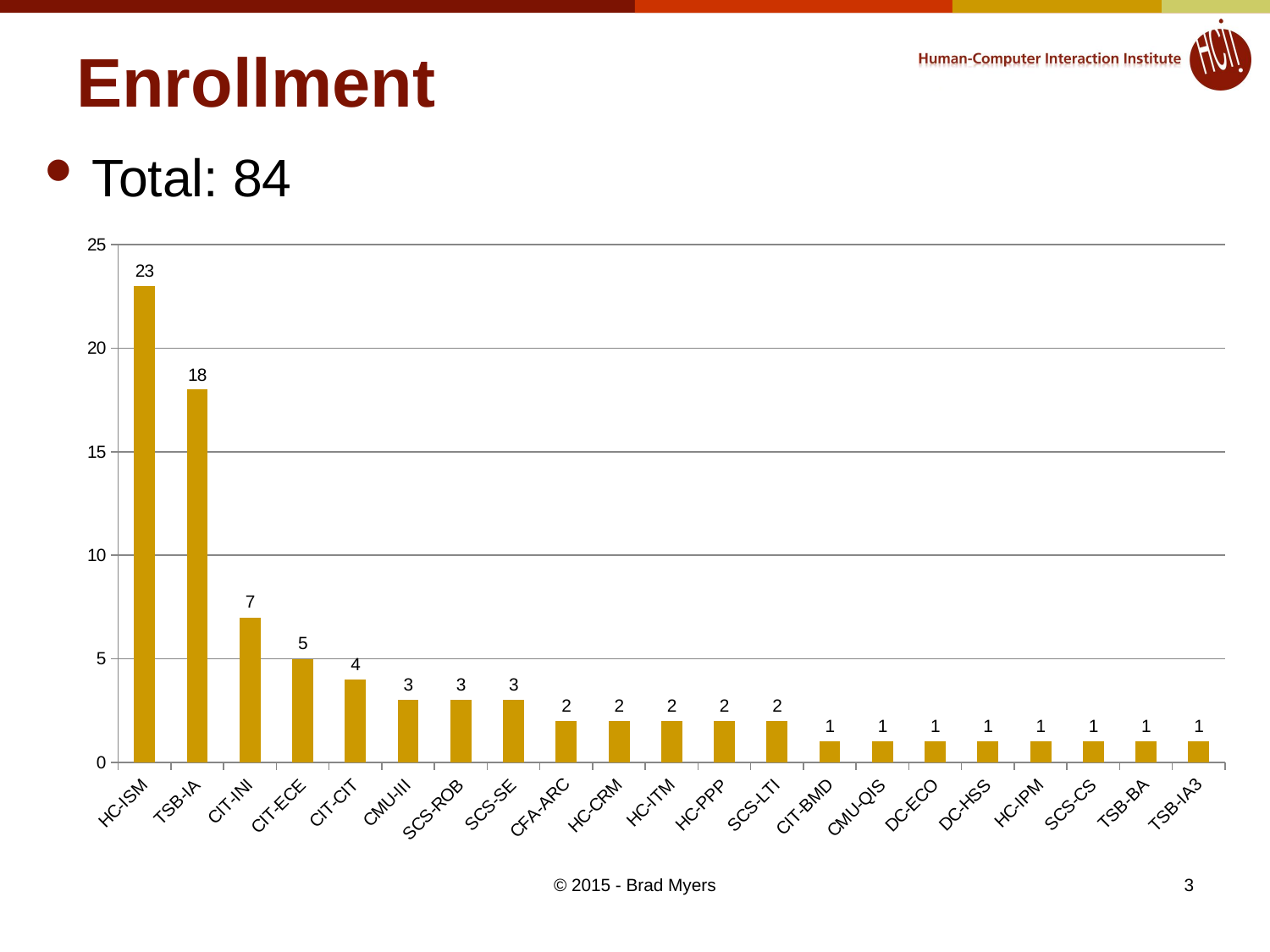
What kind of chart is shown on the slide? bar chart What is the enrollment value for SCS-LTI? 2 What is the enrollment value for CIT-CIT? 4 What is the enrollment value for TSB-IA? 18 How many categories are shown on the x axis of the chart? 21 Is the value for TSB-IA greater or less than 20? less What is the difference between the enrollment values for HC-ISM and TSB-IA? 5 Do the values rise or fall moving from left to right along the x axis? fall What is the enrollment value for HC-ISM? 23 Which has a larger enrollment value, CIT-ECE or CMU-III? CIT-ECE What is the enrollment value for CIT-INI? 7 Which category has the highest enrollment? HC-ISM